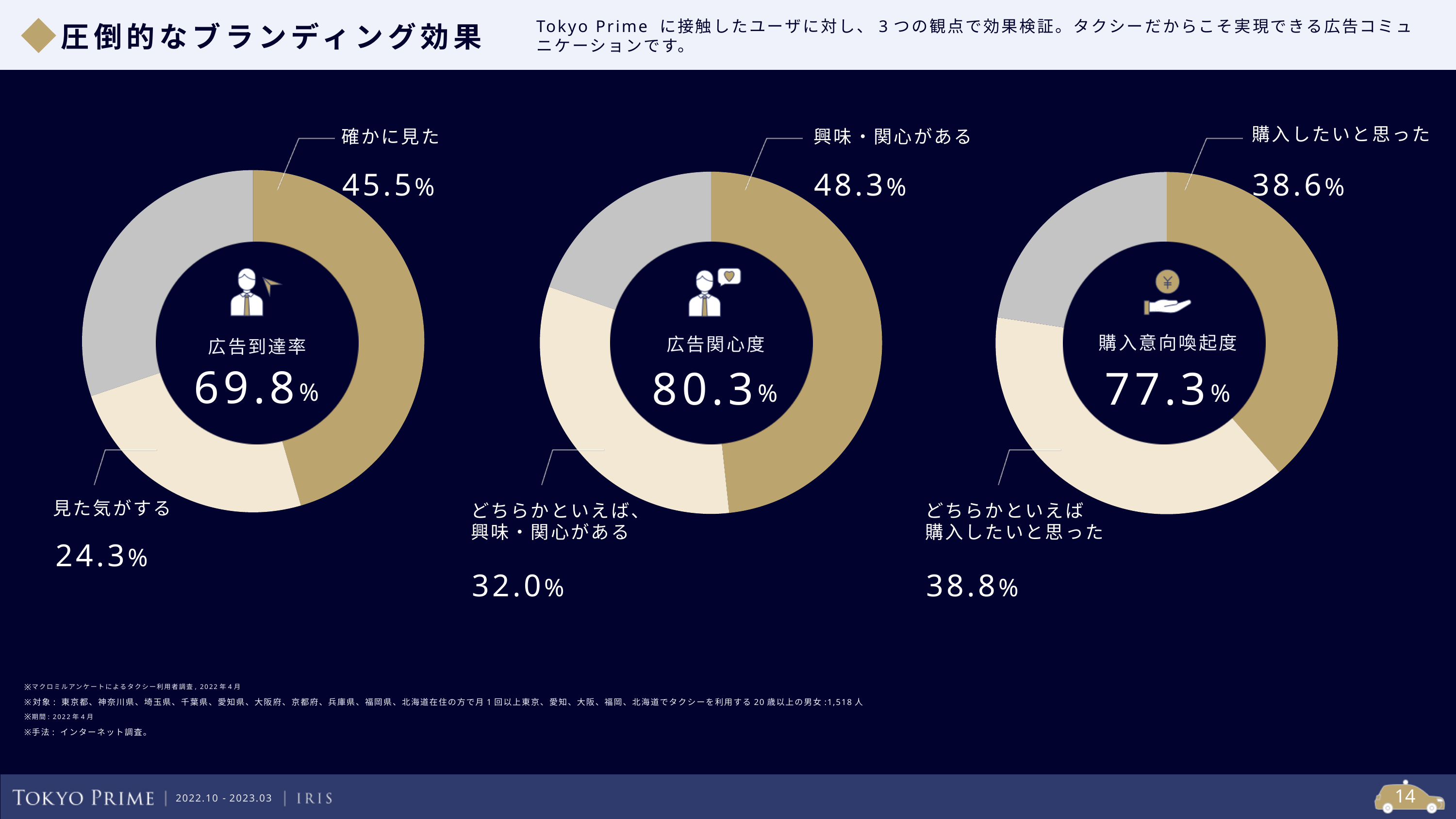
In the 広告到達率 chart (left), which is larger: 確かに見た or 見た気がする? 確かに見た What overall value is shown in the centre of the 広告関心度 chart (middle)? 80.3% In the 購入意向喚起度 chart (right), what percentage is labelled for どちらかといえば購入したいと思った? 38.8% In the 広告到達率 chart (left), what is the combined share of 確かに見た and 見た気がする? 69.8% In the 広告関心度 chart (middle), what percentage is labelled for どちらかといえば、興味・関心がある? 32.0% In the 広告到達率 chart (left), what percentage is labelled for 確かに見た? 45.5% In the 広告到達率 chart (left), what percentage is labelled for 見た気がする? 24.3% In the 広告関心度 chart (middle), what is the difference between 興味・関心がある and どちらかといえば、興味・関心がある? 16.3% What kind of chart is used for the three metrics on this slide? Donut (pie) chart Which of the three charts shows the highest centre value? 広告関心度 In the 広告関心度 chart (middle), what percentage is labelled for 興味・関心がある? 48.3% In the 購入意向喚起度 chart (right), what percentage is labelled for 購入したいと思った? 38.6%